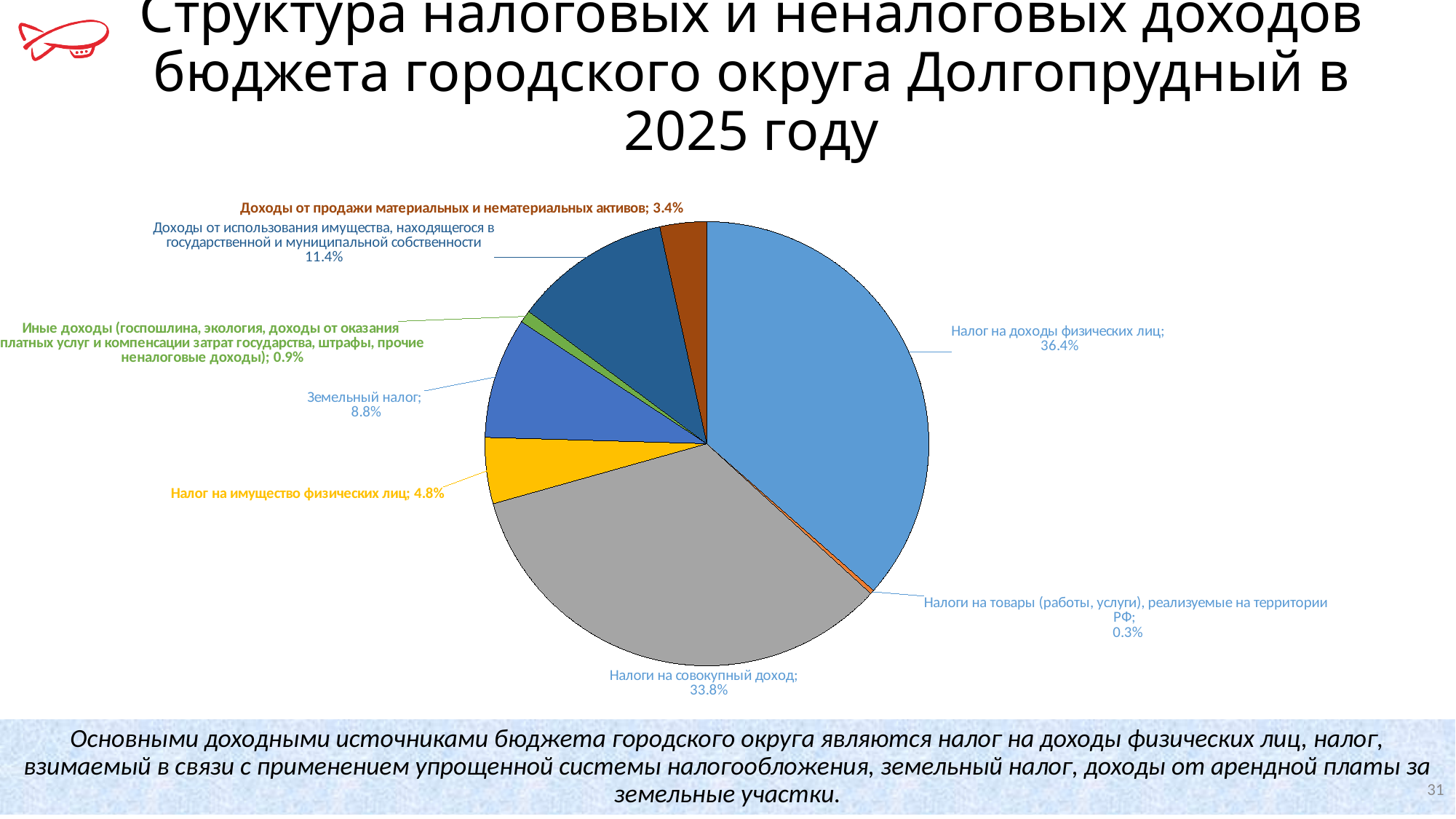
Which category has the smallest slice of the pie? Налоги на товары (работы, услуги), реализуемые на территории РФ What is the value shown for "Земельный налог"? 8.8% What share of the pie does "Налог на доходы физических лиц" have? 36.4% What is the difference between the shares of "Налог на доходы физических лиц" and "Налоги на совокупный доход"? 2.6% Which category has the largest slice of the pie? Налог на доходы физических лиц What is the value shown for "Доходы от использования имущества, находящегося в государственной и муниципальной собственности"? 11.4% What year does the chart title refer to? 2025 What kind of chart is shown on the slide? Pie chart What share of the pie does "Налоги на совокупный доход" have? 33.8% Which is larger: "Земельный налог" or "Налог на имущество физических лиц"? Земельный налог What is the combined share of "Налог на имущество физических лиц" and "Доходы от продажи материальных и нематериальных активов"? 8.2% How many categories (slices) does the pie chart have? 8